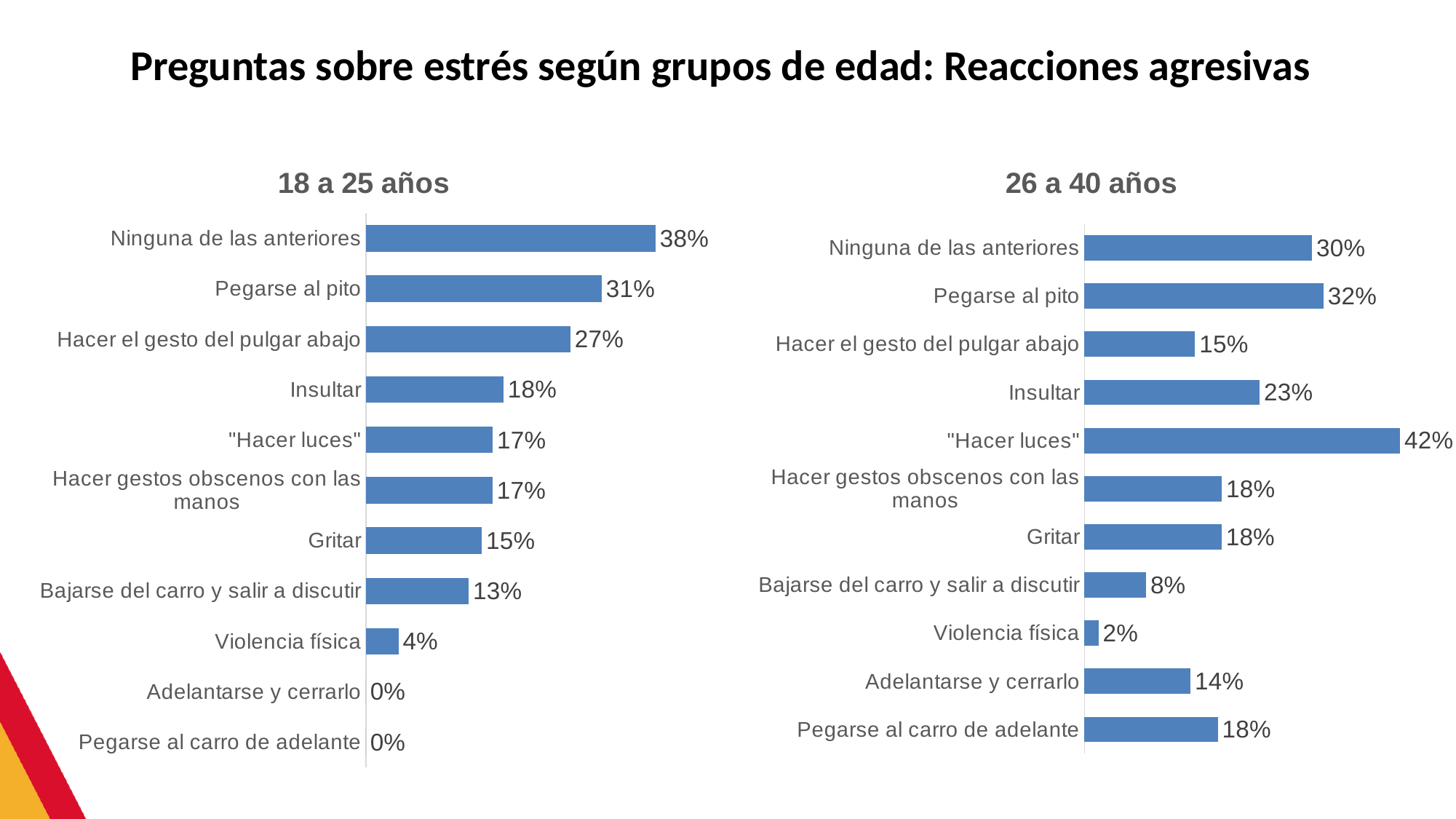
In the "18 a 25 años" chart, what is the difference between "Ninguna de las anteriores" and "Pegarse al pito"? 7% What type of chart is the "26 a 40 años" chart? Bar chart In the "18 a 25 años" chart, how many categories are shown? 11 In the "26 a 40 años" chart, what is the value for "Hacer el gesto del pulgar abajo"? 15% What is the title of the slide? Preguntas sobre estrés según grupos de edad: Reacciones agresivas In the "26 a 40 años" chart, what is the difference between "Hacer luces" and "Insultar"? 19% In the "26 a 40 años" chart, what is the value for "Adelantarse y cerrarlo"? 14% In the "18 a 25 años" chart, what is the value for "Pegarse al pito"? 31% Which is larger: "Insultar" in the "18 a 25 años" chart or "Insultar" in the "26 a 40 años" chart? 26 a 40 años In the "26 a 40 años" chart, which category has the highest value? "Hacer luces" In the "26 a 40 años" chart, which category has the lowest value? Violencia física In the "18 a 25 años" chart, which category has the highest value? Ninguna de las anteriores